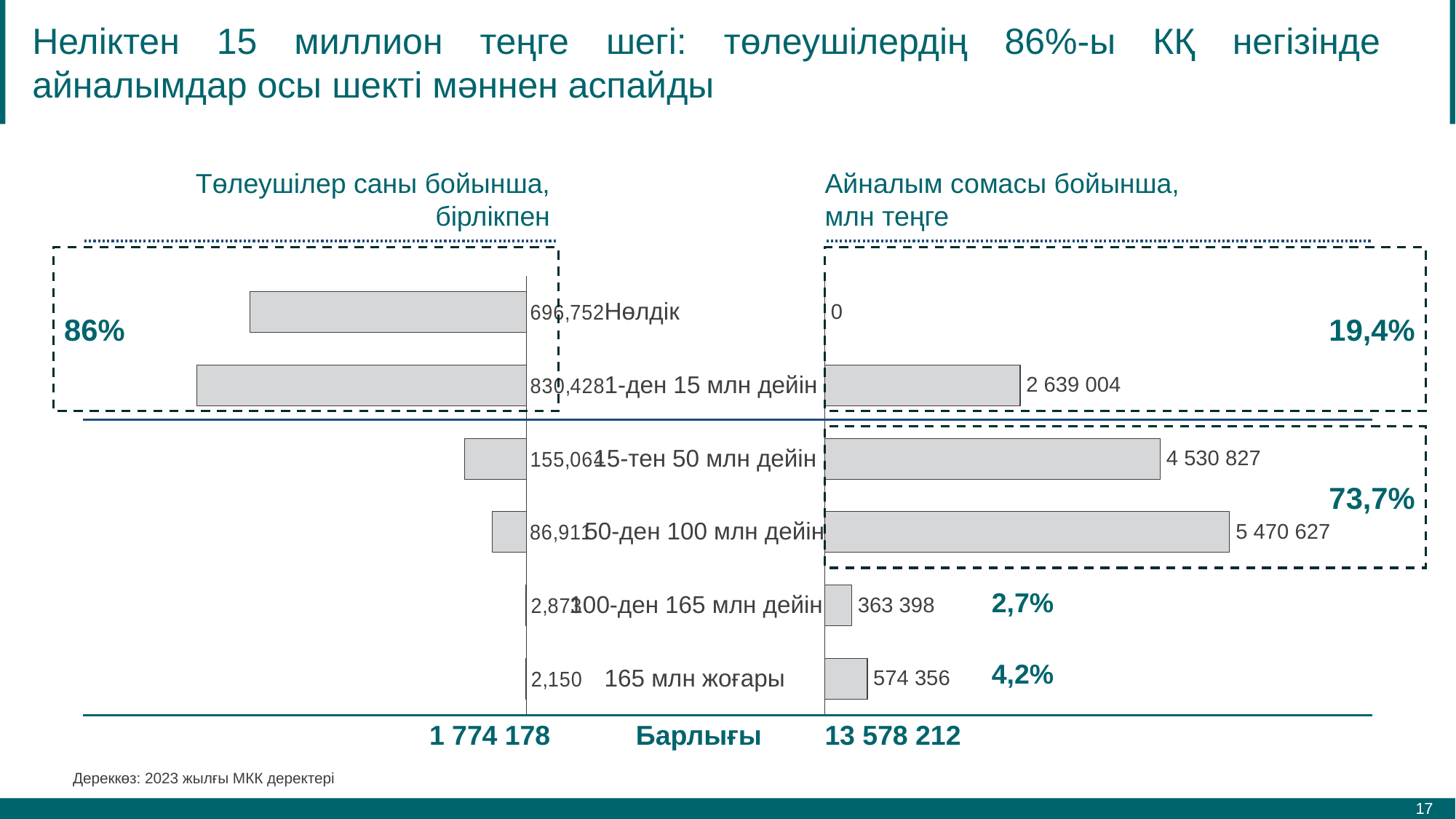
How many categories are shown on the left chart (Төлеушілер саны бойынша, бірлікпен)? 6 On the right chart (Айналым сомасы бойынша, млн теңге), which category has the highest value? 50-ден 100 млн дейін On the left chart (Төлеушілер саны бойынша, бірлікпен), what is the value for 165 млн жоғары? 2,150 What total (Барлығы) is shown under the right chart (Айналым сомасы бойынша, млн теңге)? 13 578 212 On the right chart (Айналым сомасы бойынша, млн теңге), what is the value for 1-ден 15 млн дейін? 2 639 004 On the right chart (Айналым сомасы бойынша, млн теңге), which is larger: 100-ден 165 млн дейін or 165 млн жоғары? 165 млн жоғары What type of chart is used on the right side of the slide (Айналым сомасы бойынша, млн теңге)? Bar chart What percentage is shown next to the dashed box around 15-тен 50 млн дейін and 50-ден 100 млн дейін on the right chart? 73,7% On the left chart (Төлеушілер саны бойынша, бірлікпен), which category has the highest value? 1-ден 15 млн дейін On the right chart (Айналым сомасы бойынша, млн теңге), what is the value for 50-ден 100 млн дейін? 5 470 627 On the right chart (Айналым сомасы бойынша, млн теңге), what is the difference between the values for 50-ден 100 млн дейін and 15-тен 50 млн дейін? 939 800 On the right chart (Айналым сомасы бойынша, млн теңге), which category has the lowest value? Нөлдік